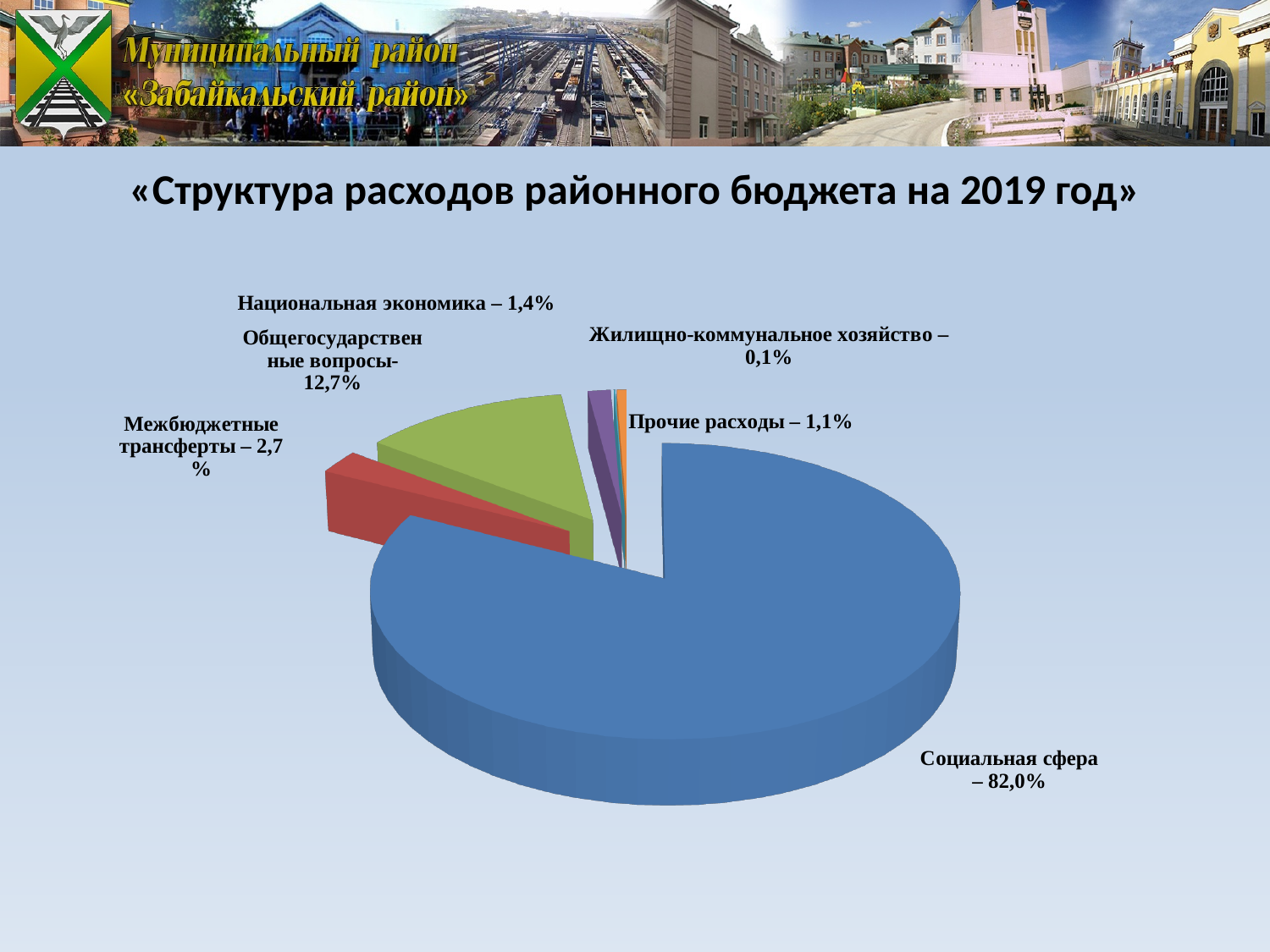
What share is labelled for Жилищно-коммунальное хозяйство? 0,1% What is the title of the chart on the slide? «Структура расходов районного бюджета на 2019 год» What type of chart is shown on the slide? Pie chart Which category has the largest share of the pie? Социальная сфера What is the difference in percentage points between Социальная сфера and Общегосударственные вопросы? 69,3% How many categories are shown in the pie chart? 6 What share of the district budget expenditure goes to Социальная сфера? 82,0% What percentage is shown for Прочие расходы? 1,1% Which category has the smallest share of the pie? Жилищно-коммунальное хозяйство What percentage is shown for Общегосударственные вопросы? 12,7% What is the value for Межбюджетные трансферты? 2,7% Which is larger: Национальная экономика or Прочие расходы? Национальная экономика